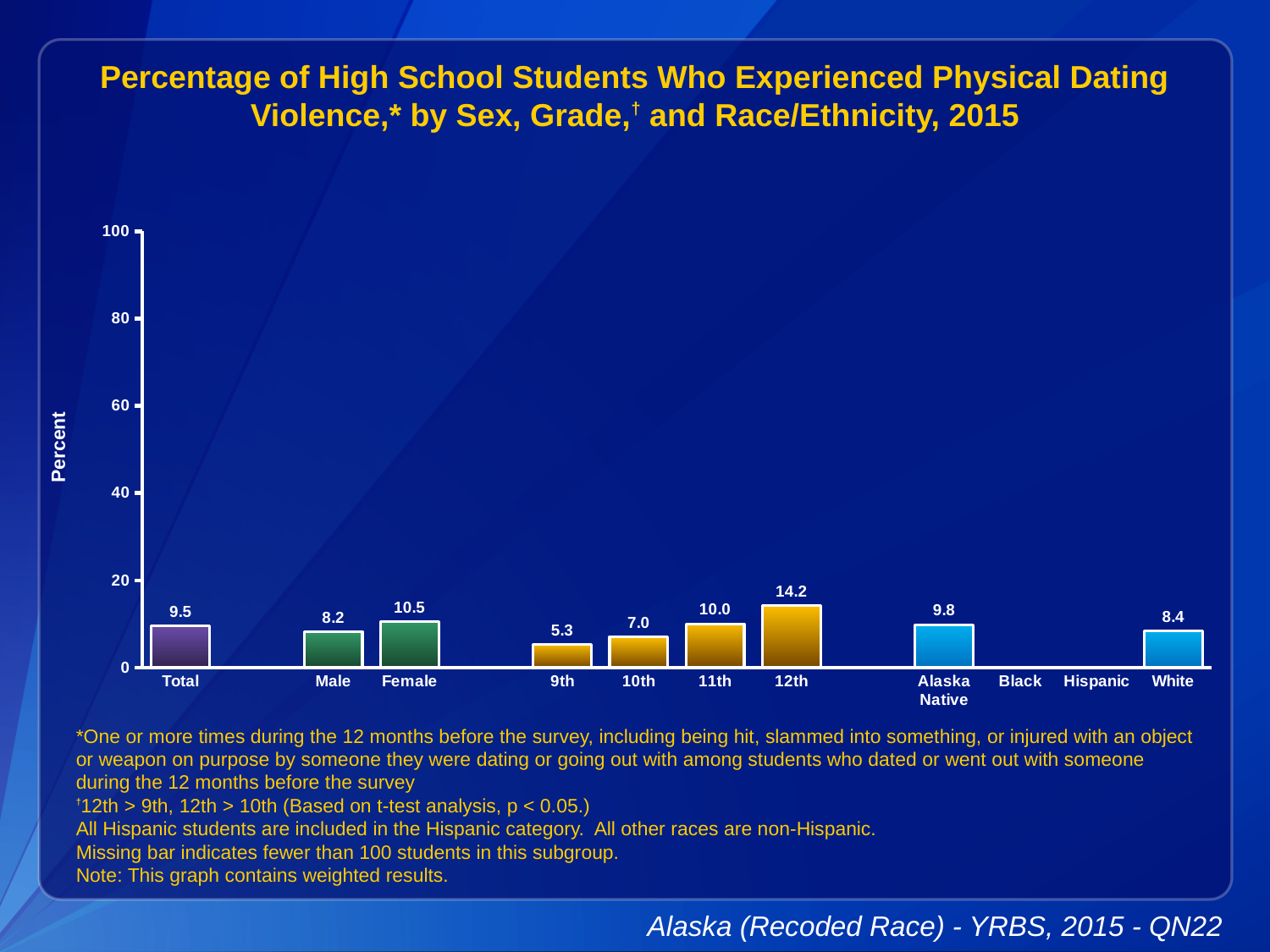
Is the value for 12th grade greater or less than 20? less Do the values rise or fall from 9th grade to 12th grade? rise What is the value for Female? 10.5 What is the value for Alaska Native? 9.8 What kind of chart is shown? bar chart What is the value for 12th grade? 14.2 Which is larger, the value for 11th grade or the value for White? 11th Which category has the lowest value among the bars shown? 9th What is the value for Total? 9.5 Which category has the highest value? 12th What is the difference between the Female and Male values? 2.3 Which race/ethnicity categories have no bar shown? Black and Hispanic